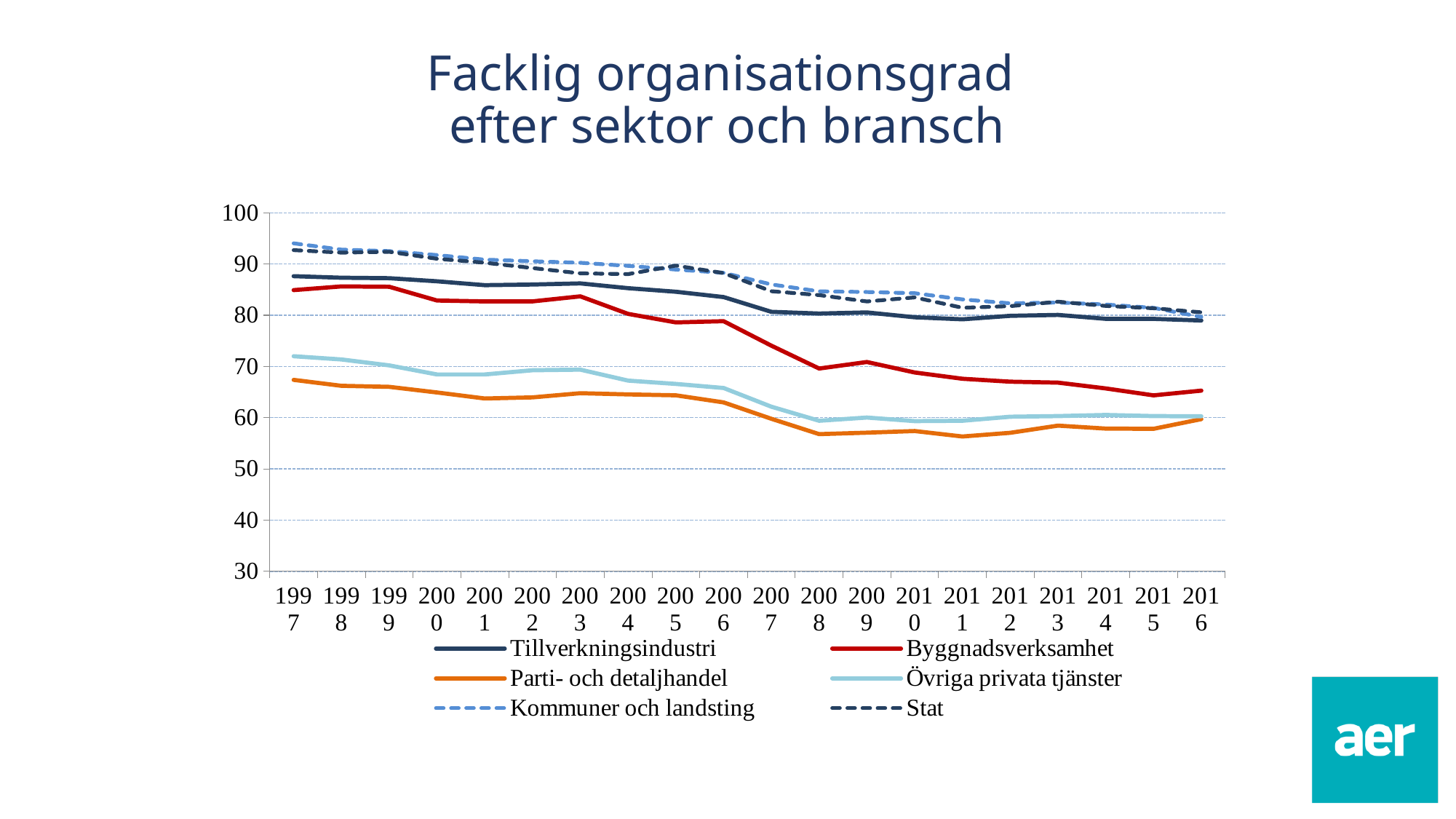
How many years are shown along the x axis? 20 Is the value for Parti- och detaljhandel in 1997 greater or less than 70? less Which series has the lowest value in 2008? Parti- och detaljhandel Does the value for Byggnadsverksamhet rise or fall from 1997 to 2016? fall In 2016, which is larger: Tillverkningsindustri or Byggnadsverksamhet? Tillverkningsindustri What kind of chart is shown on the slide? line chart Which series has the highest value in 1997? Kommuner och landsting Is the value for Byggnadsverksamhet in 2016 greater or less than 70? less Is the value for Tillverkningsindustri in 1997 greater or less than 80? greater How many series does the legend list? 6 Which two series are drawn with dashed lines? Kommuner och landsting and Stat